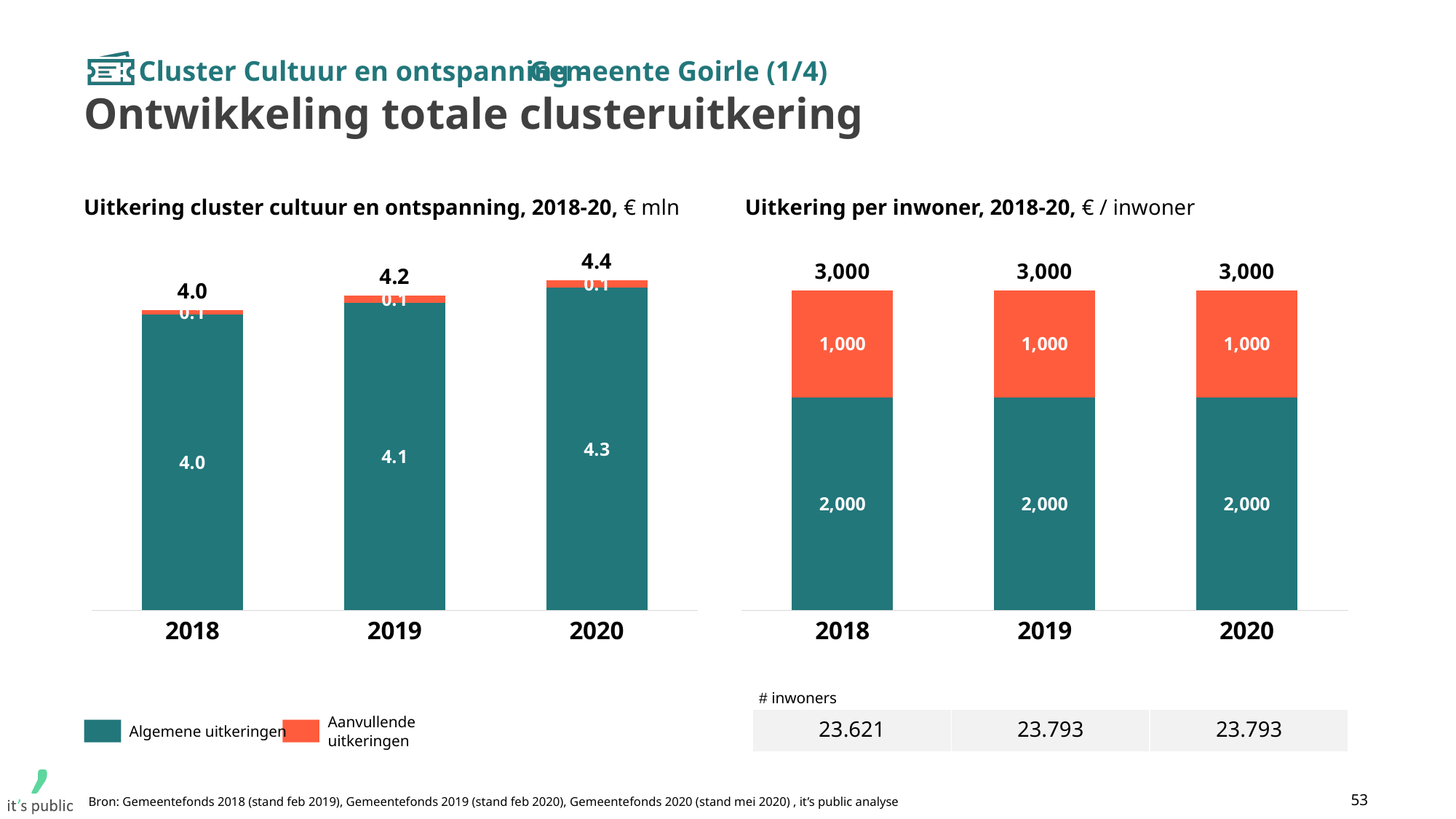
How many years are shown on the x axis of the chart 'Uitkering per inwoner, 2018-20'? 3 In the chart 'Uitkering cluster cultuur en ontspanning, 2018-20', do the total values rise or fall from 2018 to 2020? rise In the chart 'Uitkering cluster cultuur en ontspanning, 2018-20', what is the value of Algemene uitkeringen in 2019? 4.1 In the chart 'Uitkering cluster cultuur en ontspanning, 2018-20', what is the value of Aanvullende uitkeringen in 2020? 0.1 In the chart 'Uitkering cluster cultuur en ontspanning, 2018-20', which year has the highest total uitkering? 2020 In the chart 'Uitkering cluster cultuur en ontspanning, 2018-20', what is the total value shown above the bar for 2020? 4.4 In the chart 'Uitkering per inwoner, 2018-20', which segment is larger in 2020: Algemene uitkeringen or Aanvullende uitkeringen? Algemene uitkeringen In the chart 'Uitkering per inwoner, 2018-20', what is the total value shown above the bar for 2019? 3,000 How many series does the legend on the slide list? 2 What kind of chart is 'Uitkering cluster cultuur en ontspanning, 2018-20'? stacked bar chart In the chart 'Uitkering cluster cultuur en ontspanning, 2018-20', what is the difference between the total for 2020 and the total for 2018? 0.4 In the chart 'Uitkering per inwoner, 2018-20', what is the value of Algemene uitkeringen in 2018? 2,000